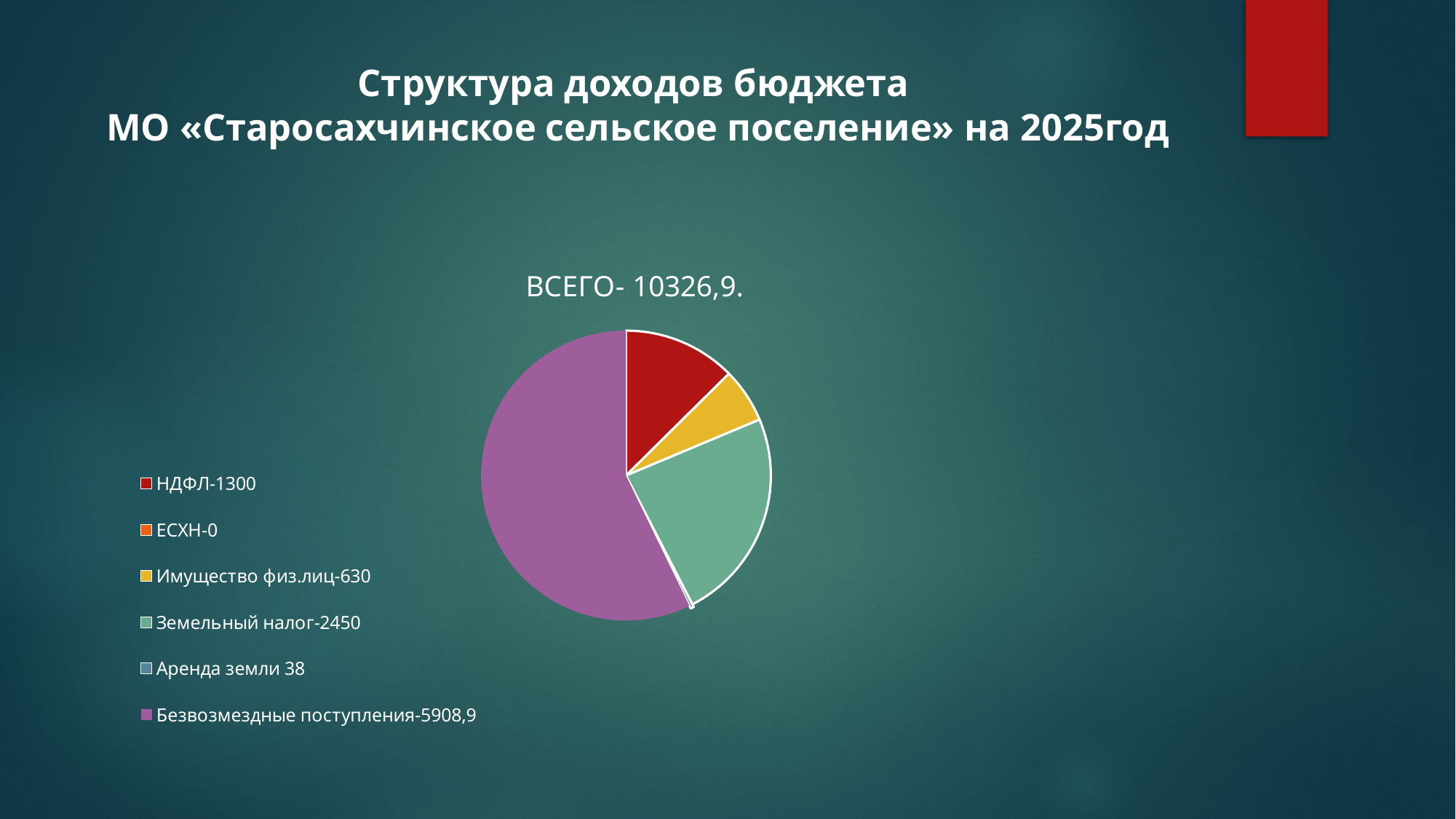
What is the value for Имущество физ.лиц? 630 What is the value for Безвозмездные поступления? 5908,9 What is the value for Аренда земли? 38 What is the value for Земельный налог? 2450 Which is larger, Земельный налог or НДФЛ? Земельный налог What is the difference between Земельный налог and НДФЛ? 1150 Which category has the largest value? Безвозмездные поступления What is the value for НДФЛ? 1300 Which category has the smallest value? ЕСХН What kind of chart is shown on the slide? pie chart How many categories does the legend list? 6 What total value is shown in the chart title? 10326,9